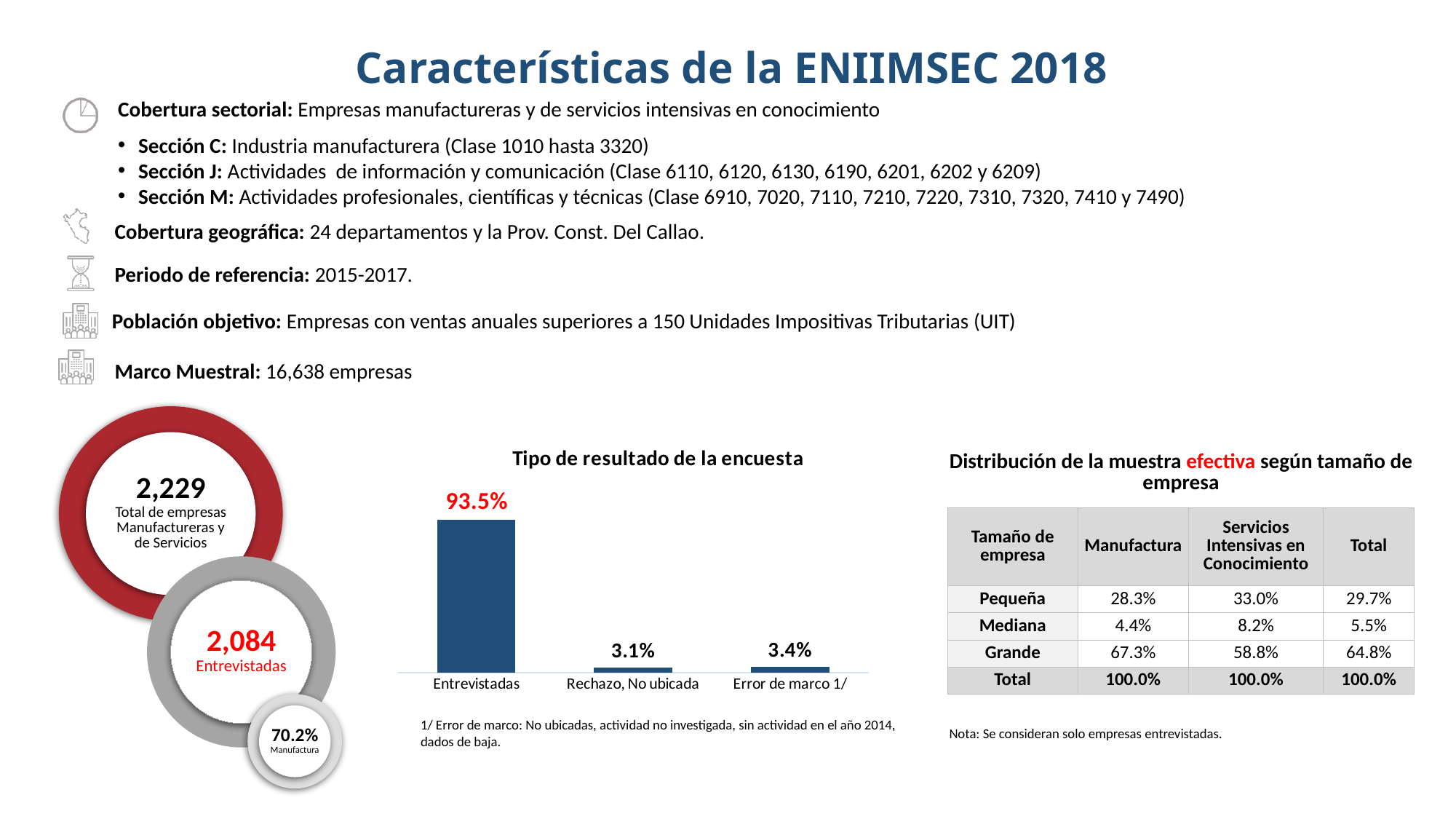
What is the title of the bar chart on the slide? Tipo de resultado de la encuesta In the chart 'Tipo de resultado de la encuesta', which is larger: the value for Entrevistadas or the value for 'Rechazo, No ubicada'? Entrevistadas Which category has the lowest value in the chart 'Tipo de resultado de la encuesta'? Rechazo, No ubicada What is the value for Entrevistadas in the chart 'Tipo de resultado de la encuesta'? 93.5% In the chart 'Tipo de resultado de la encuesta', what is the difference between the values for 'Error de marco 1/' and 'Rechazo, No ubicada'? 0.3% What is the value for 'Error de marco 1/' in the chart 'Tipo de resultado de la encuesta'? 3.4% What is the value for 'Rechazo, No ubicada' in the chart 'Tipo de resultado de la encuesta'? 3.1% Which category has the highest value in the chart 'Tipo de resultado de la encuesta'? Entrevistadas How many categories are shown in the chart 'Tipo de resultado de la encuesta'? 3 What kind of chart is 'Tipo de resultado de la encuesta'? Bar chart What colour are the bars in the chart 'Tipo de resultado de la encuesta'? Dark blue In the chart 'Tipo de resultado de la encuesta', what is the difference between the values for Entrevistadas and 'Error de marco 1/'? 90.1%